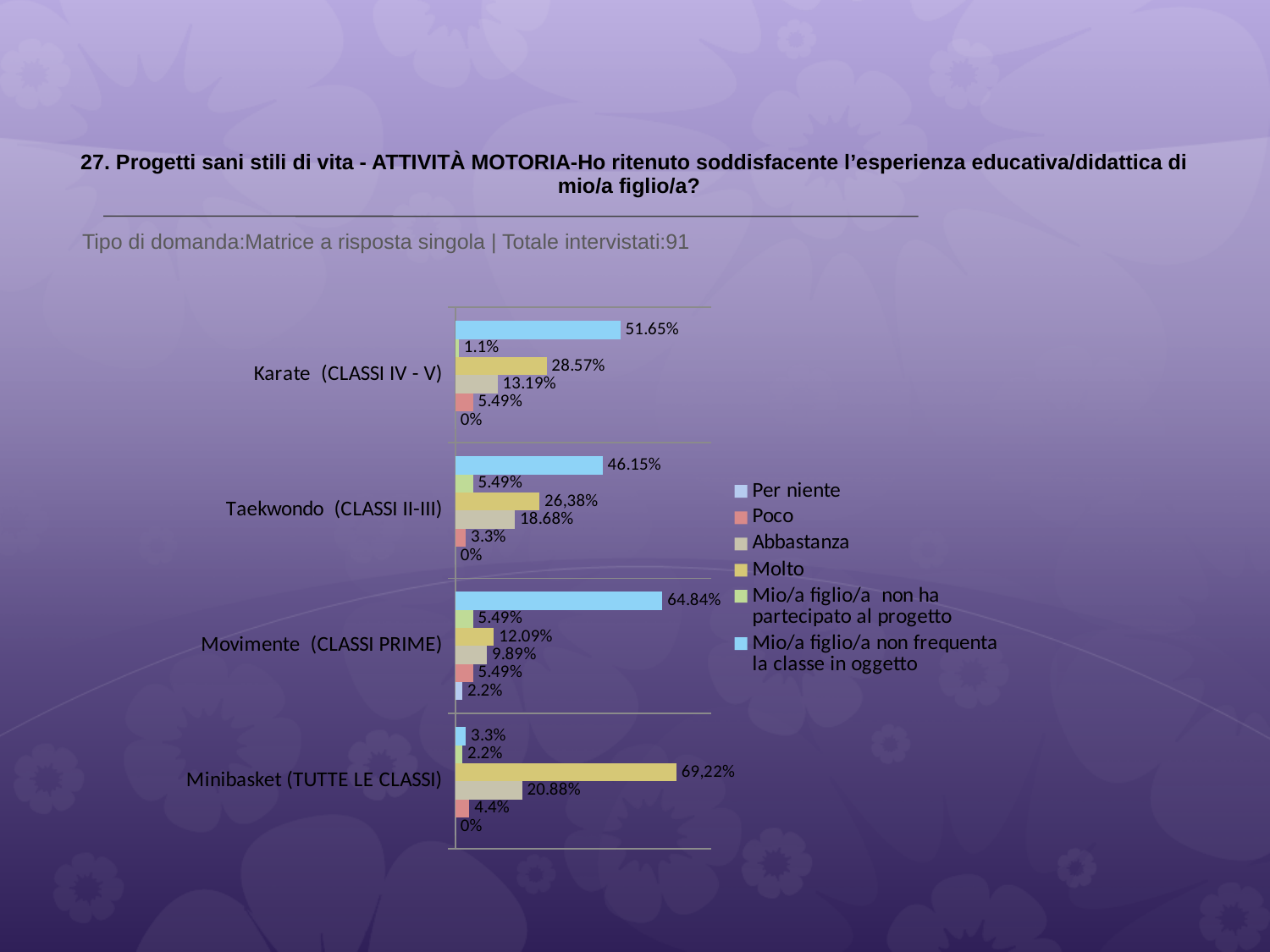
What is the total number of respondents stated on the slide? 91 Which is larger: the "Abbastanza" value for Karate (CLASSI IV - V) or for Minibasket (TUTTE LE CLASSI)? Minibasket (TUTTE LE CLASSI) Which activity has the lowest value for "Mio/a figlio/a non frequenta la classe in oggetto"? Minibasket (TUTTE LE CLASSI) What is the value for "Mio/a figlio/a non frequenta la classe in oggetto" for Movimente (CLASSI PRIME)? 64.84% What is the value for "Poco" for Karate (CLASSI IV - V)? 5.49% How many activity categories are shown on the chart? 4 What is the difference between the "Molto" values for Karate (CLASSI IV - V) and Movimente (CLASSI PRIME)? 16.48% Which activity has the highest value for "Molto"? Minibasket (TUTTE LE CLASSI) What is the value for "Molto" for Minibasket (TUTTE LE CLASSI)? 69,22% How many series does the legend list? 6 What kind of chart is shown on the slide? bar chart What is the value for "Abbastanza" for Taekwondo (CLASSI II-III)? 18.68%